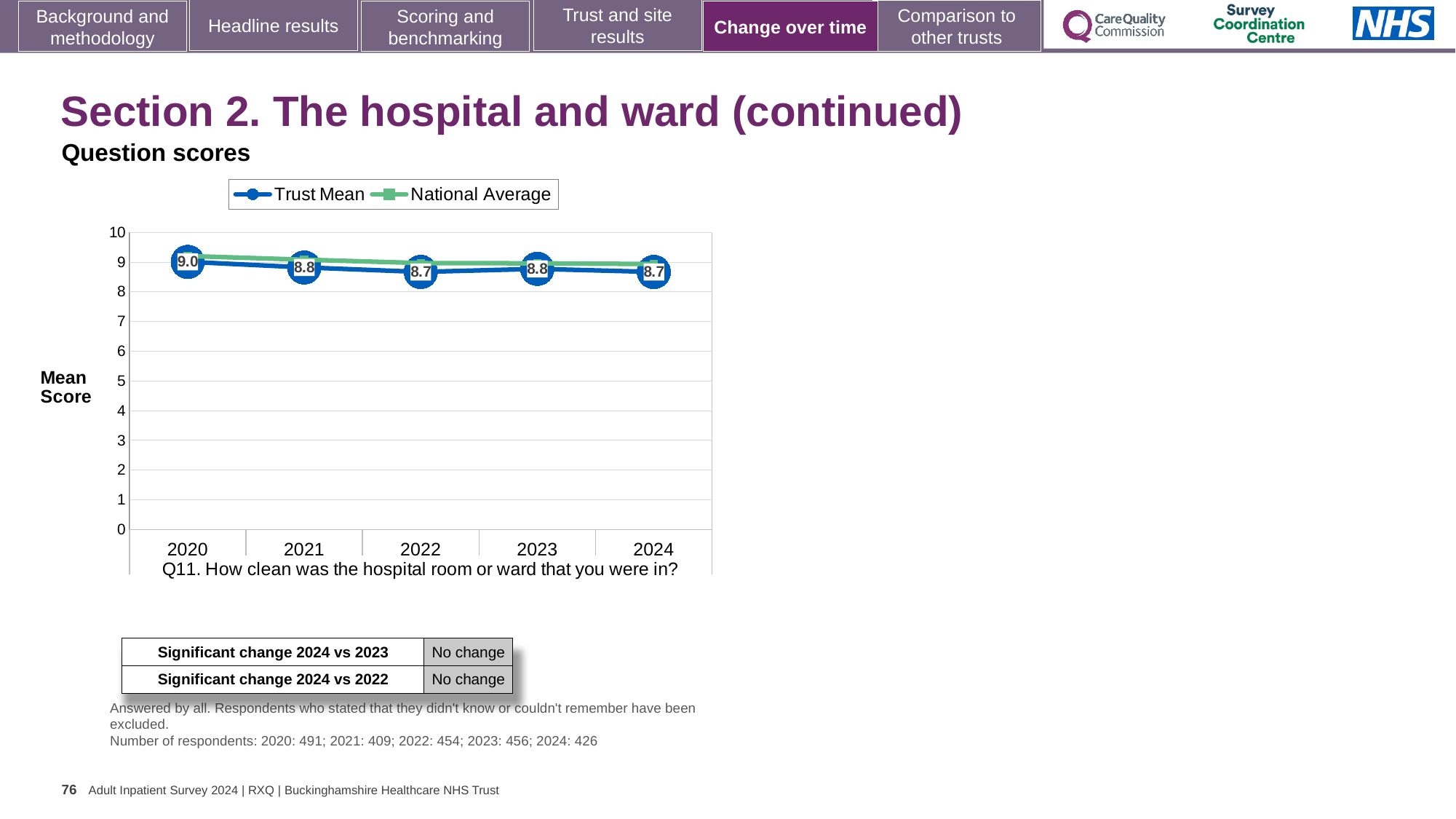
How many series does the chart legend list? 2 In which year is the Trust Mean score highest? 2020 What is the difference between the Trust Mean score in 2020 and in 2024? 0.3 What is the Trust Mean score for 2024? 8.7 What is the Trust Mean score for 2020? 9.0 What kind of chart is shown on the slide? Line chart Does the Trust Mean score rise or fall from 2020 to 2024? Fall How many years are shown on the x axis of the chart? 5 What is the Trust Mean score for 2022? 8.7 Which is larger, the Trust Mean score for 2020 or for 2021? 2020 Which survey question does the chart show scores for? Q11. How clean was the hospital room or ward that you were in? Is the National Average value for 2020 greater or less than 8? greater